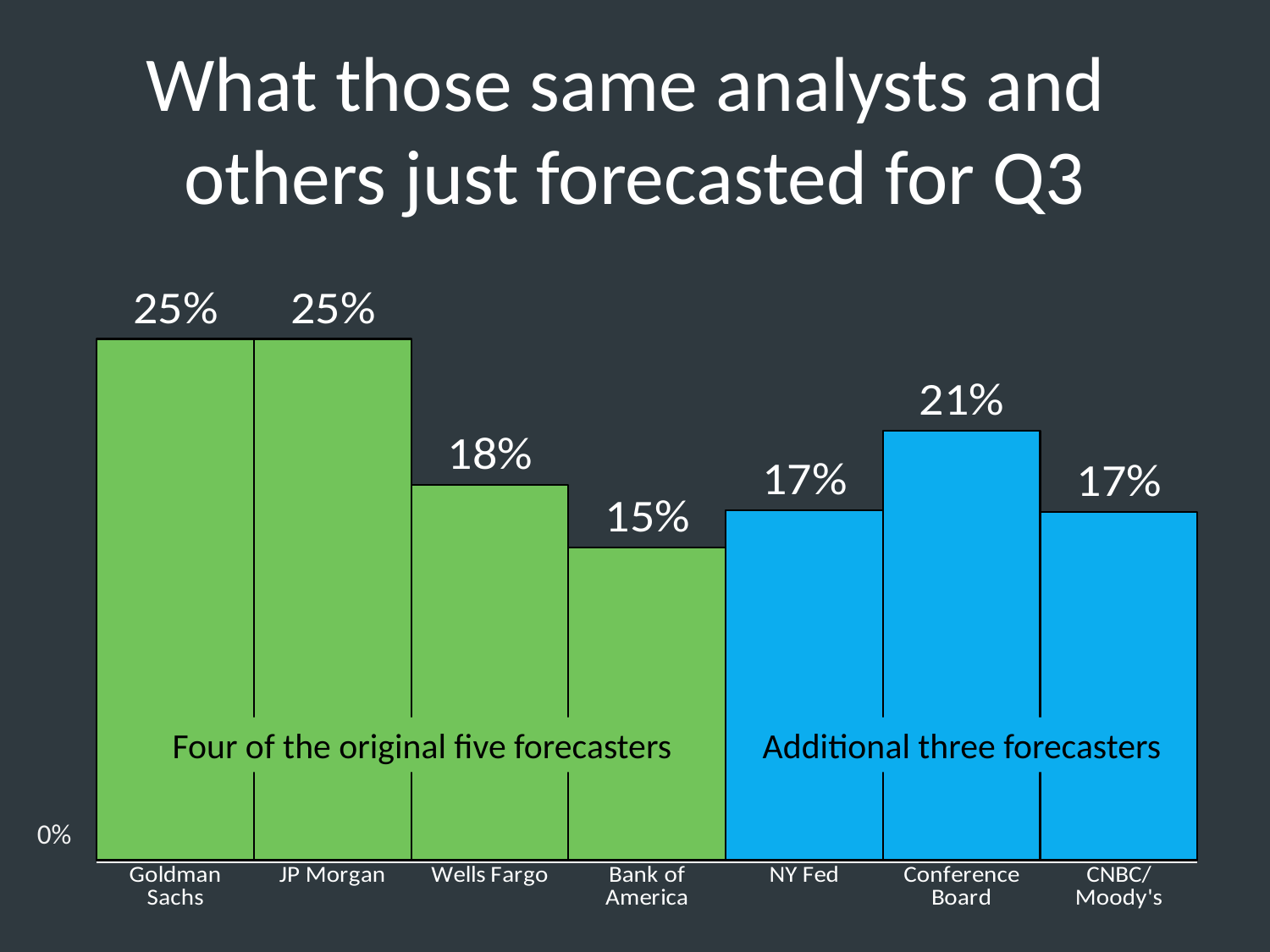
Which is larger, the value for Wells Fargo or the value for CNBC/Moody's? Wells Fargo What kind of chart is shown on the slide? Bar chart What label is written across the blue bars? Additional three forecasters Do the values rise or fall from Goldman Sachs to Bank of America? Fall What is the forecast value for Bank of America? 15% What is the difference between the Conference Board value and the NY Fed value? 4% What is the forecast value for Wells Fargo? 18% Which forecaster has the lowest value on the chart? Bank of America What is the forecast value for Conference Board? 21% How many forecasters are shown on the chart? 7 What is the difference between the Goldman Sachs value and the Bank of America value? 10% What is the forecast value for NY Fed? 17%